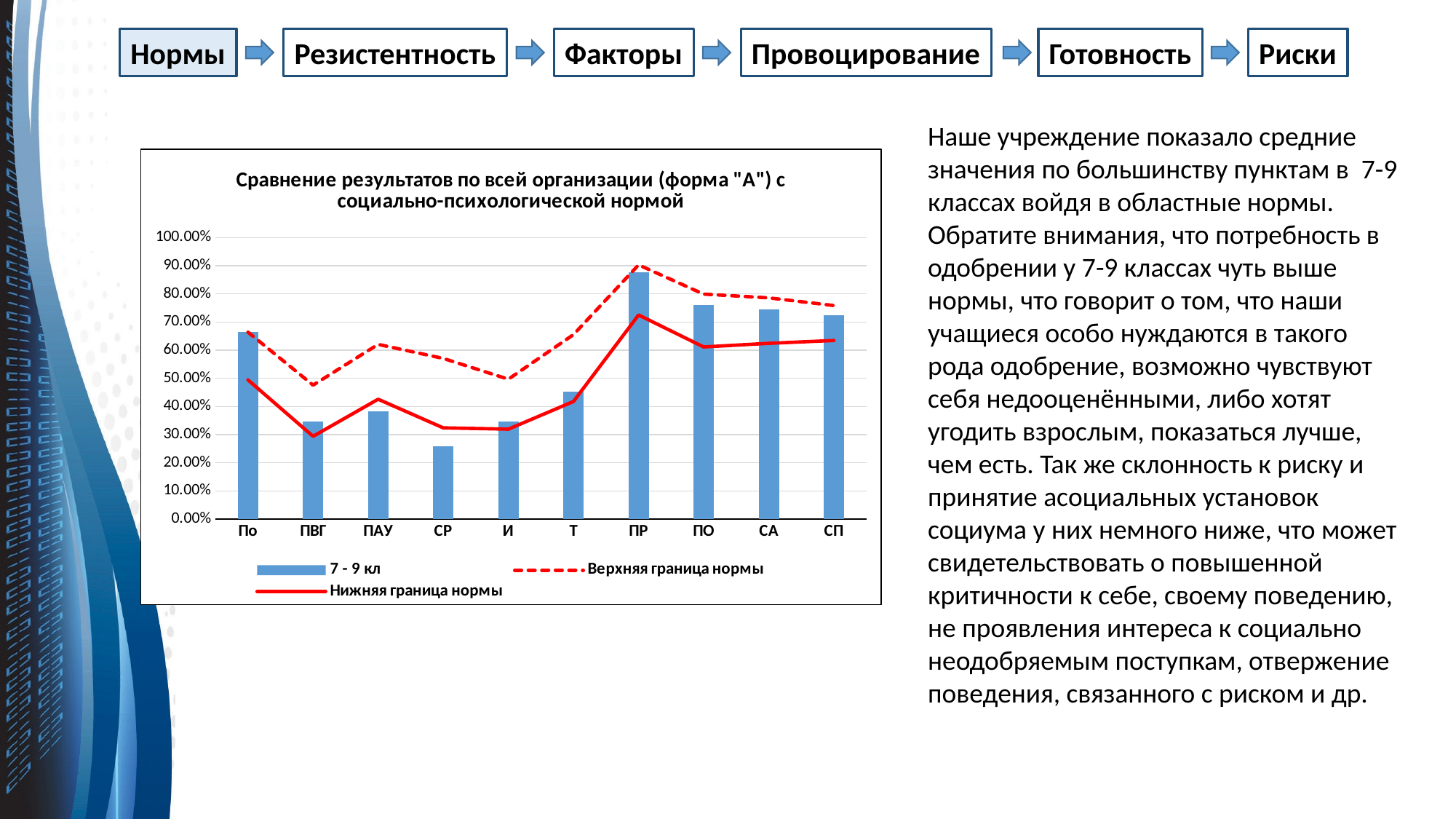
Is the 7 - 9 кл value for По greater or less than 60.00%? greater Is the 7 - 9 кл value for Т greater or less than 50.00%? less How many series does the chart legend list? 3 Which category has the highest bar for 7 - 9 кл? ПР Which legend entry is drawn as a dashed red line? Верхняя граница нормы Which category has the lowest bar for 7 - 9 кл? СР What is the title of the chart? Сравнение результатов по всей организации (форма "А") с социально-психологической нормой Which has the larger 7 - 9 кл bar, ПО or ПВГ? ПО How many categories are shown on the x axis of the chart? 10 What kind of chart is shown on the slide? A bar chart with two line series Is the 7 - 9 кл value for ПР greater or less than 80.00%? greater